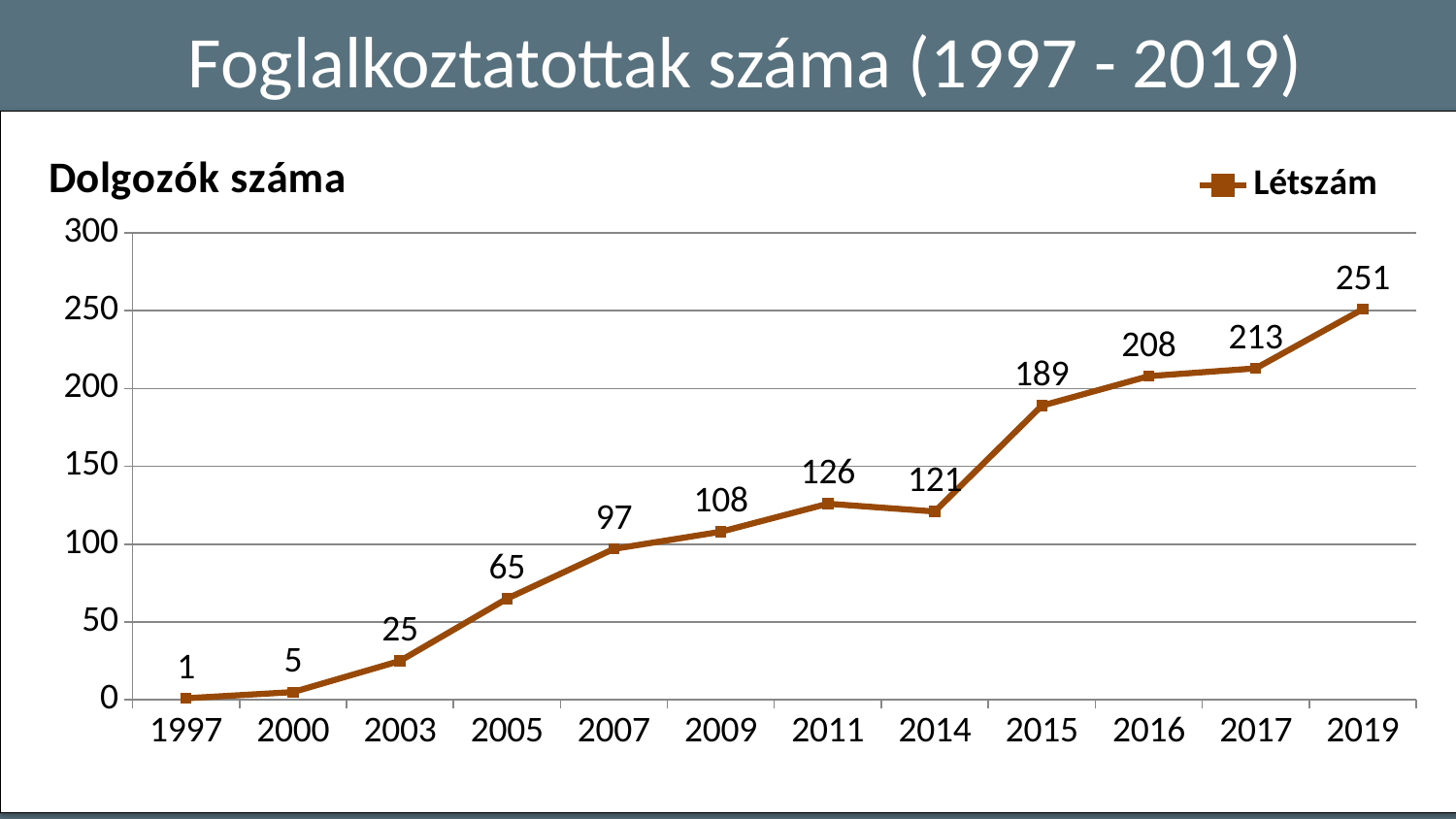
Which year has the highest value? 2019 How many years are plotted on the x axis? 12 Which year has the lowest value? 1997 What is the value for 2007? 97 How many series does the legend list? 1 What kind of chart is shown? line chart Which is larger, the value for 2011 or the value for 2014? 2011 Do the values generally rise or fall from 1997 to 2019? rise What is the value for 2015? 189 What is the difference between the values for 2019 and 2017? 38 Is the value for 2016 greater or less than 200? greater What is the name of the series in the legend? Létszám